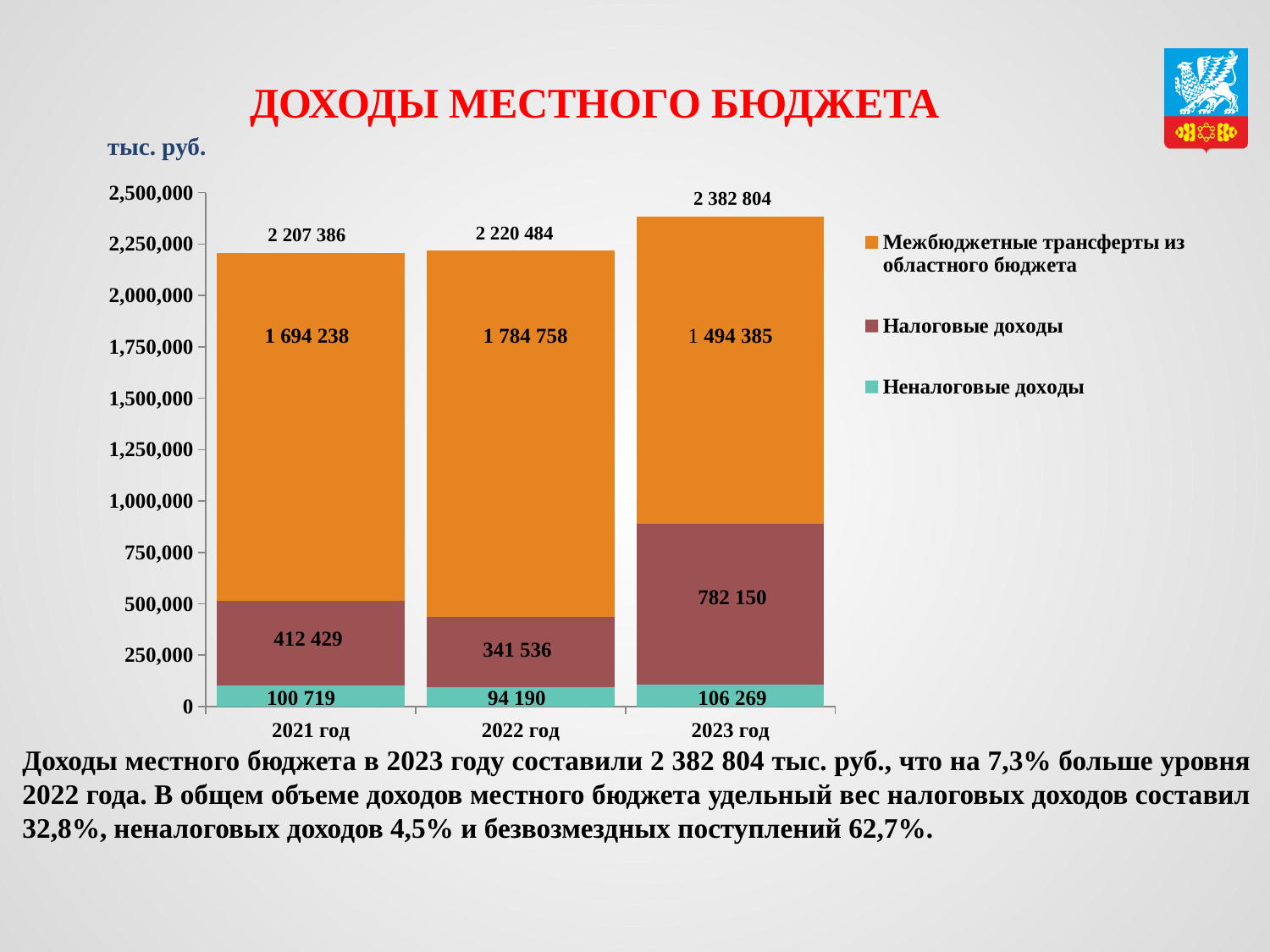
Which is larger: Межбюджетные трансферты из областного бюджета in 2022 год or in 2023 год? 2022 год What is the total of the stacked bar for 2023 год? 2 382 804 What is the difference in Межбюджетные трансферты из областного бюджета between 2022 год and 2021 год? 90 520 How many series does the legend list? 3 What is the value of Налоговые доходы for 2023 год? 782 150 Which year has the highest total income? 2023 год What kind of chart is shown on the slide? Stacked bar chart What is the difference in Налоговые доходы between 2023 год and 2022 год? 440 614 What is the value of Межбюджетные трансферты из областного бюджета for 2021 год? 1 694 238 Which year has the lowest value of Неналоговые доходы? 2022 год What is the value of Неналоговые доходы for 2022 год? 94 190 What is the total of the stacked bar for 2021 год? 2 207 386